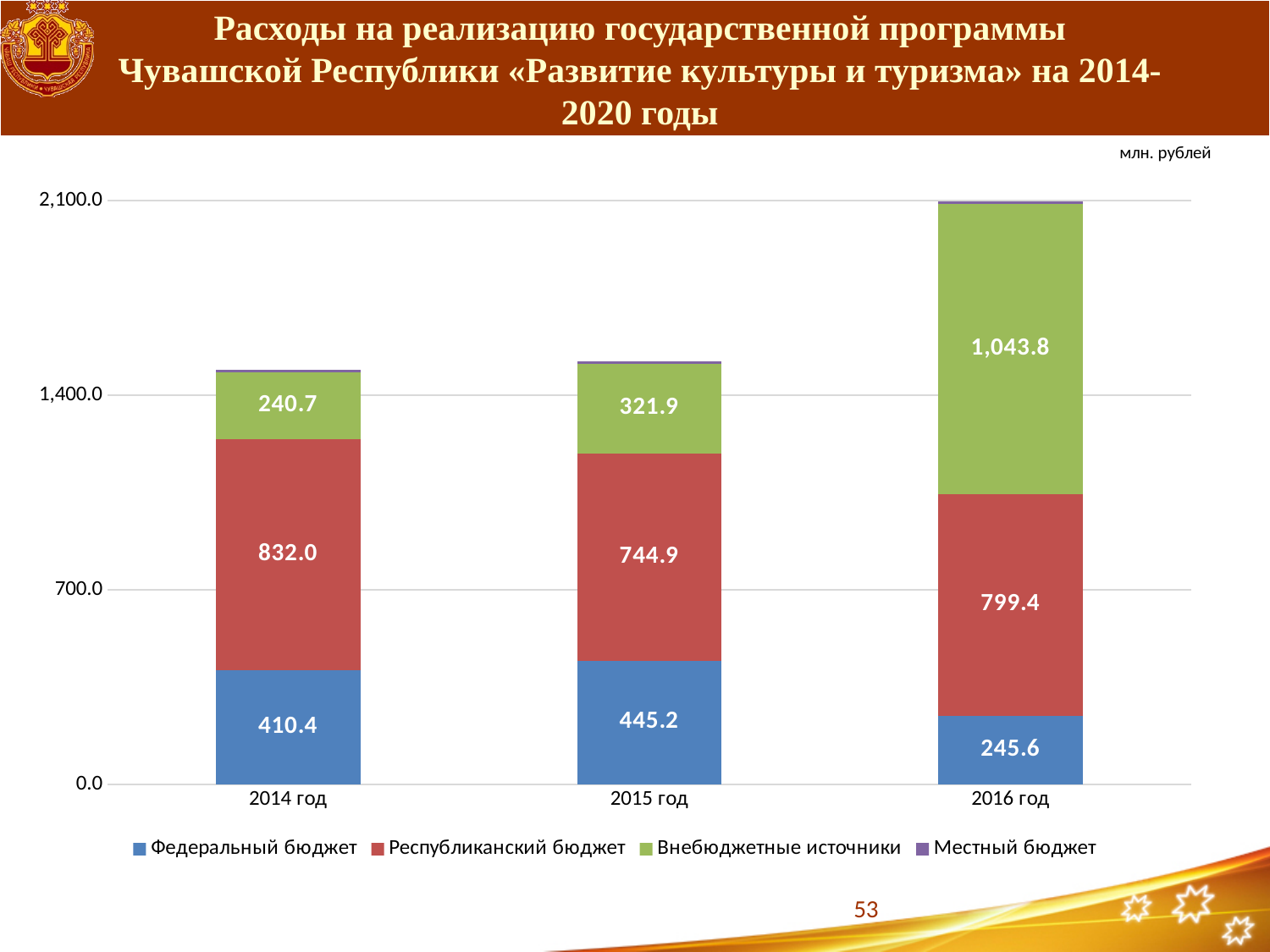
In which year is the value of Федеральный бюджет the lowest? 2016 год What is the value of Республиканский бюджет for 2016 год? 799.4 What type of chart is shown on the slide? stacked bar chart In which year is the value of Внебюджетные источники the highest? 2016 год What is the difference between Республиканский бюджет in 2014 год and 2015 год? 87.1 What is the value of Федеральный бюджет for 2014 год? 410.4 What is the value of Внебюджетные источники for 2015 год? 321.9 Does the value of Внебюджетные источники rise or fall from 2014 год to 2016 год? rise How many series does the legend list? 4 How many years (categories) are shown on the x axis? 3 Which is larger: Федеральный бюджет in 2015 год or in 2016 год? 2015 год Is the total height of the 2016 год bar greater or less than 1,400.0? greater